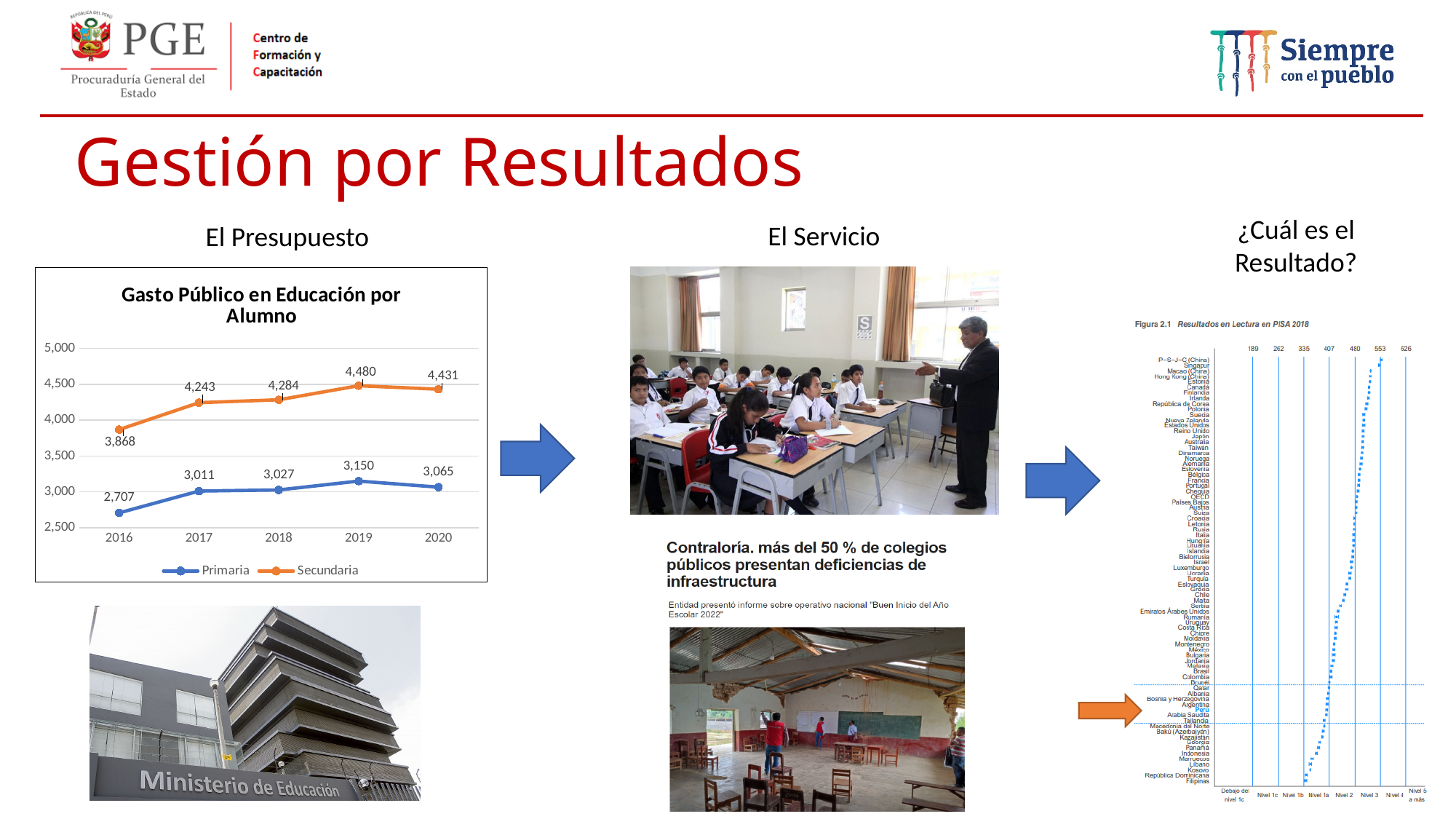
In the 'Gasto Público en Educación por Alumno' chart, does the Secundaria series rise or fall from 2016 to 2019? Rise In the 'Gasto Público en Educación por Alumno' chart, what is the value for Primaria in 2020? 3,065 In the 'Gasto Público en Educación por Alumno' chart, is the Secundaria value for 2016 greater or less than 4,000? less In the 'Gasto Público en Educación por Alumno' chart, which is larger: the Primaria value in 2019 or the Primaria value in 2020? 2019 In the 'Gasto Público en Educación por Alumno' chart, what is the value for Secundaria in 2019? 4,480 In the 'Gasto Público en Educación por Alumno' chart, which year has the lowest value for Primaria? 2016 What kind of chart is 'Gasto Público en Educación por Alumno'? Line chart In the 'Gasto Público en Educación por Alumno' chart, what is the difference between the Secundaria and Primaria values in 2018? 1,257 How many years are shown on the x axis of the 'Gasto Público en Educación por Alumno' chart? 5 In the 'Gasto Público en Educación por Alumno' chart, which year has the highest value for Secundaria? 2019 In the 'Gasto Público en Educación por Alumno' chart, what is the value for Primaria in 2016? 2,707 How many series does the legend of the 'Gasto Público en Educación por Alumno' chart list? 2